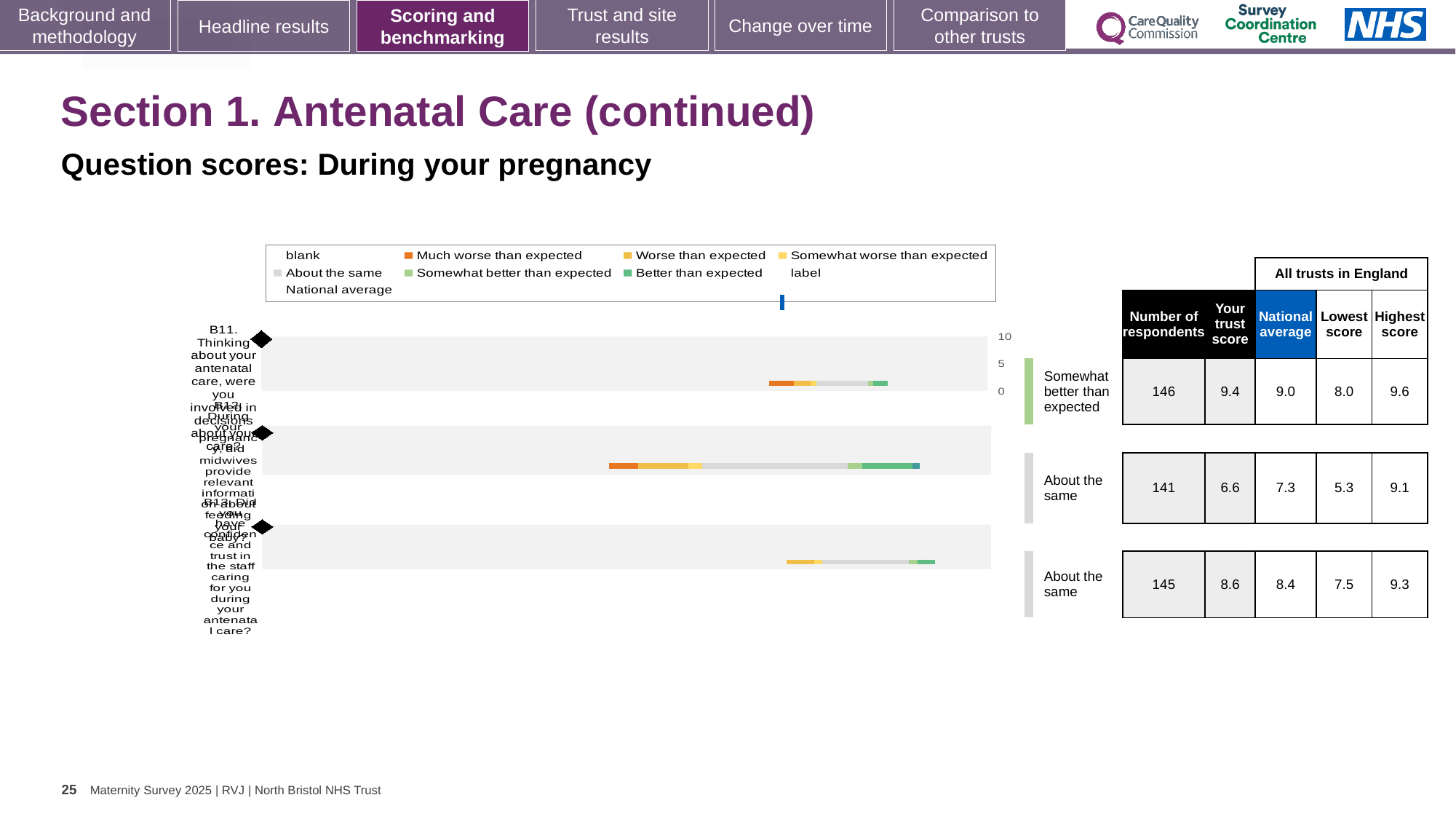
What is the maximum value shown on the chart's score axis? 10 Which question has the lowest national average? B12 What benchmark category is shown for question B12? About the same What is the trust score for question B11 (involved in decisions about your antenatal care)? 9.4 By how much does the trust score for B11 exceed its national average? 0.4 What is the difference between the highest score and the lowest score for question B12? 3.8 Which question has the highest trust score? B11 How many respondents answered question B13 (confidence and trust in staff during antenatal care)? 145 What is the national average for question B12 (midwives providing relevant information about feeding your baby)? 7.3 How many questions (B11, B12, B13) are plotted in the chart? 3 What kind of chart is used to show the question scores on this slide? bar chart For question B13, which is larger: the trust score or the national average? trust score